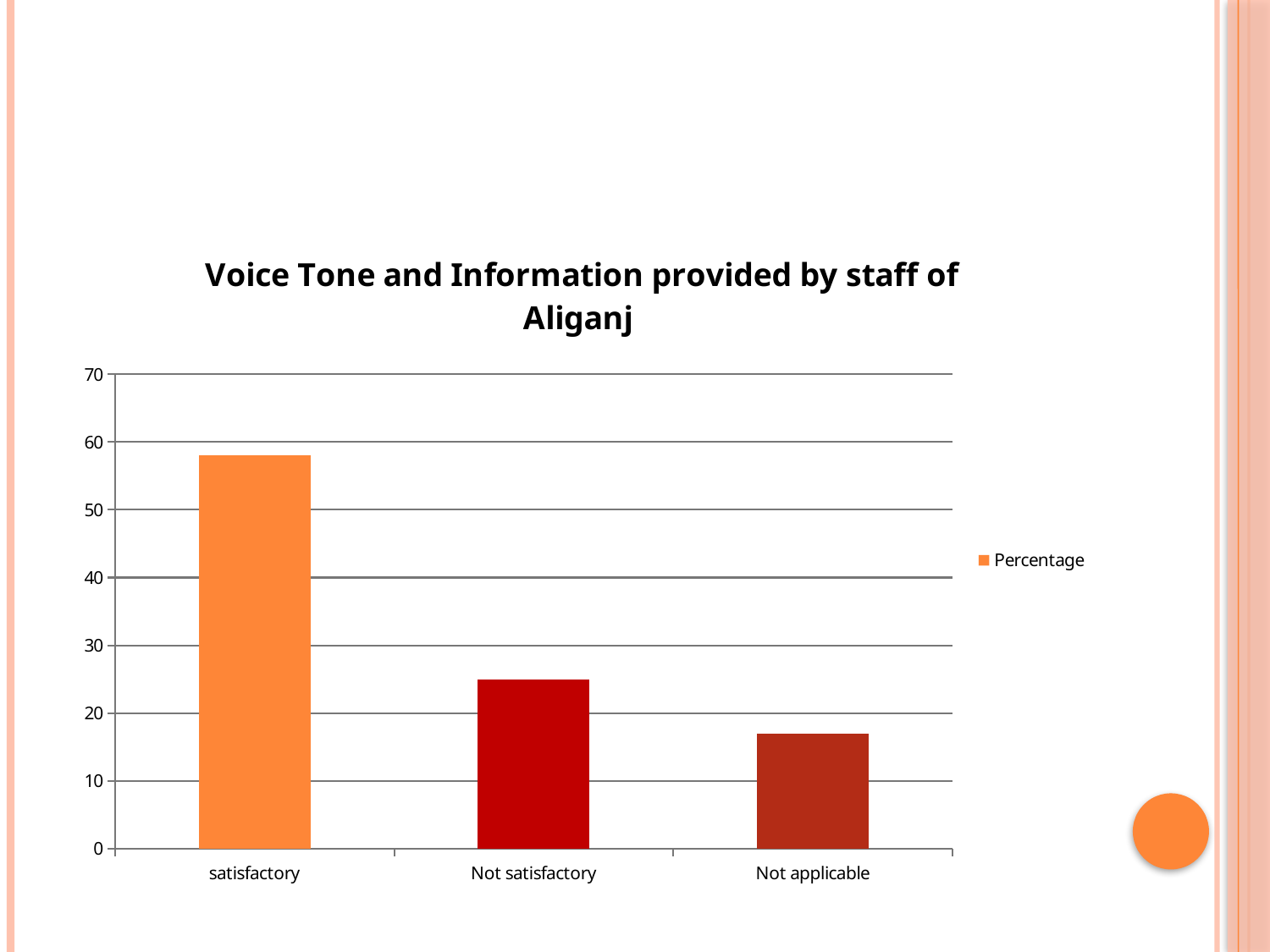
Which category has the lowest value? Not applicable Is the value for Not satisfactory greater or less than 20? greater Which is larger, the value for Not satisfactory or the value for Not applicable? Not satisfactory Is the value for Not applicable greater or less than 20? less What is the title of the chart? Voice Tone and Information provided by staff of Aliganj What kind of chart is shown on the slide? bar chart Is the value for satisfactory greater or less than 60? less How many categories are shown on the x axis of the chart? 3 What is the name of the series shown in the legend? Percentage How many series does the legend list? 1 Which category has the highest value? satisfactory